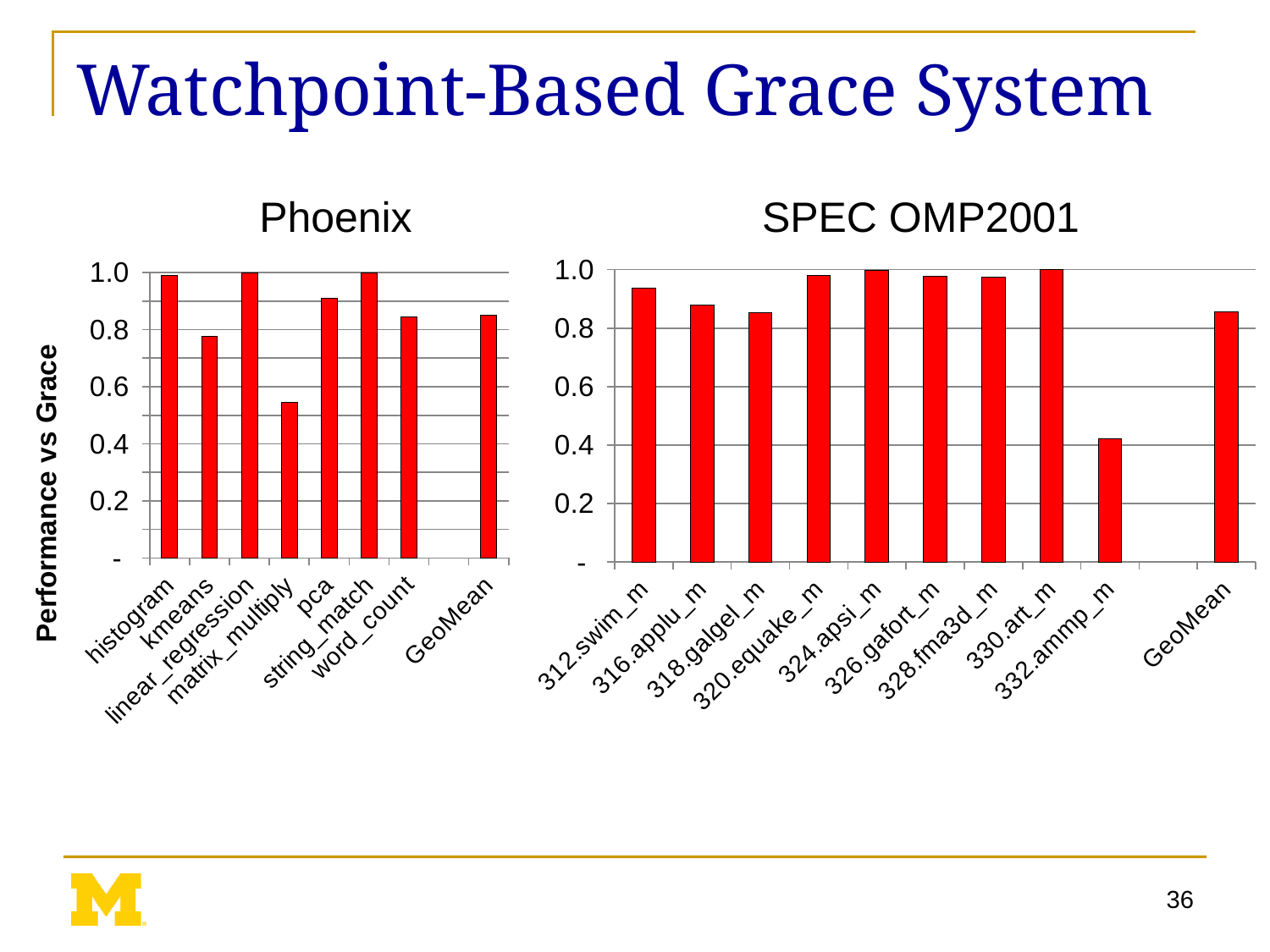
In the SPEC OMP2001 chart, is the value for 332.ammp_m greater or less than 0.6? less In the Phoenix chart, is the value for histogram greater or less than 0.8? greater In the SPEC OMP2001 chart, is the value for 312.swim_m greater or less than 0.8? greater How many bars are plotted in the SPEC OMP2001 chart? 10 What is the label on the vertical axis of the Phoenix chart? Performance vs Grace In the SPEC OMP2001 chart, which category has the lowest value? 332.ammp_m In the SPEC OMP2001 chart, which is larger, the value for 312.swim_m or the value for 332.ammp_m? 312.swim_m How many bars are plotted in the Phoenix chart? 8 In the Phoenix chart, which category has the lowest value? matrix_multiply In the Phoenix chart, which is larger, the value for kmeans or the value for matrix_multiply? kmeans What kind of chart is the Phoenix chart? bar chart